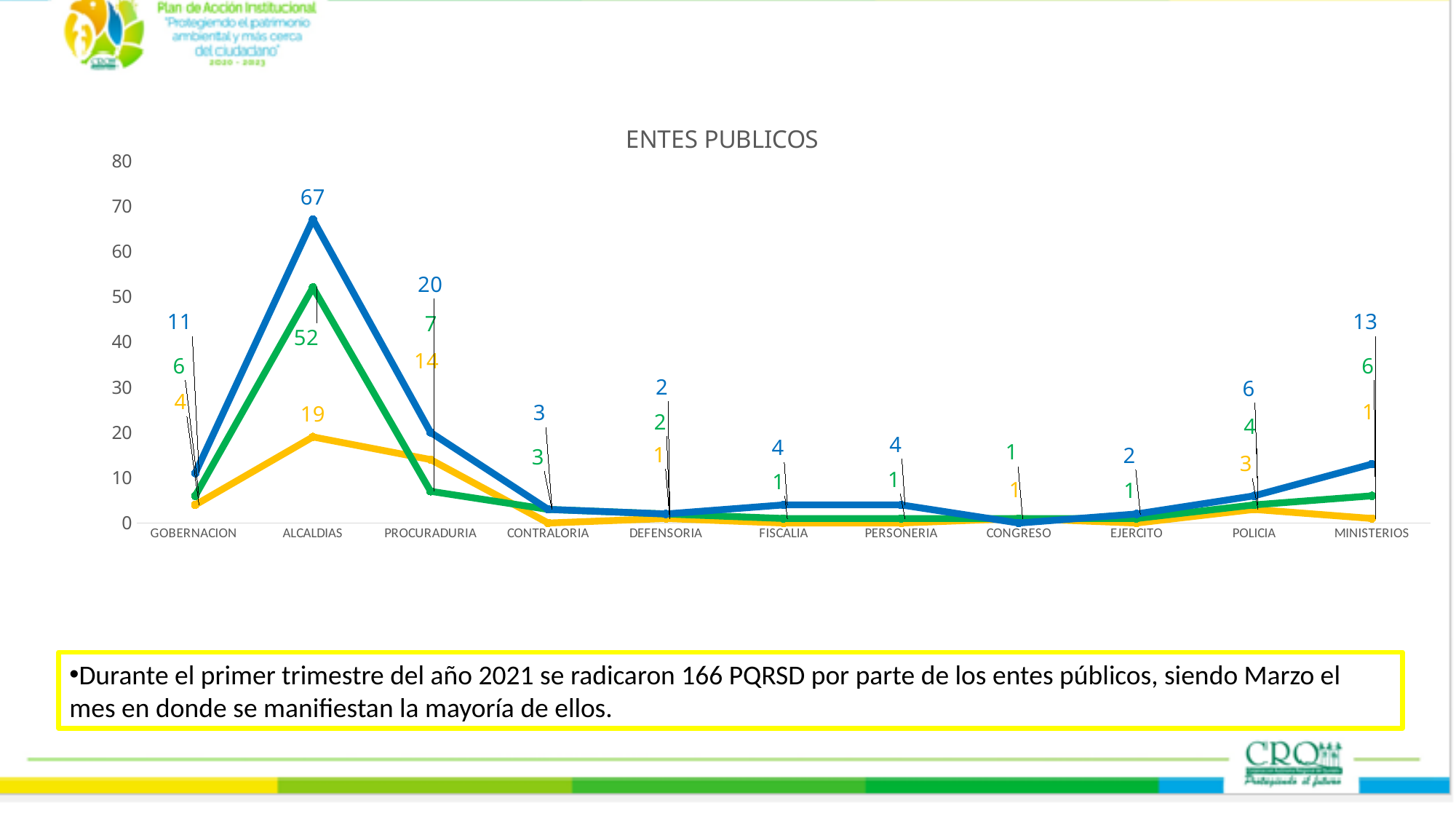
What is the value of the blue line for ALCALDIAS? 67 Which is larger for GOBERNACION, the blue line value or the yellow line value? the blue line value How many categories are shown on the x axis of the chart? 11 What is the value of the green line for ALCALDIAS? 52 What type of chart is shown on the slide? line chart What is the value of the yellow line for PROCURADURIA? 14 What is the value of the yellow line for ALCALDIAS? 19 Is the value of the blue line for ALCALDIAS greater or less than 60? greater What is the difference between the blue line and the green line for ALCALDIAS? 15 What is the title of the chart? ENTES PUBLICOS What is the value of the blue line for MINISTERIOS? 13 Which category has the highest value on the blue line? ALCALDIAS